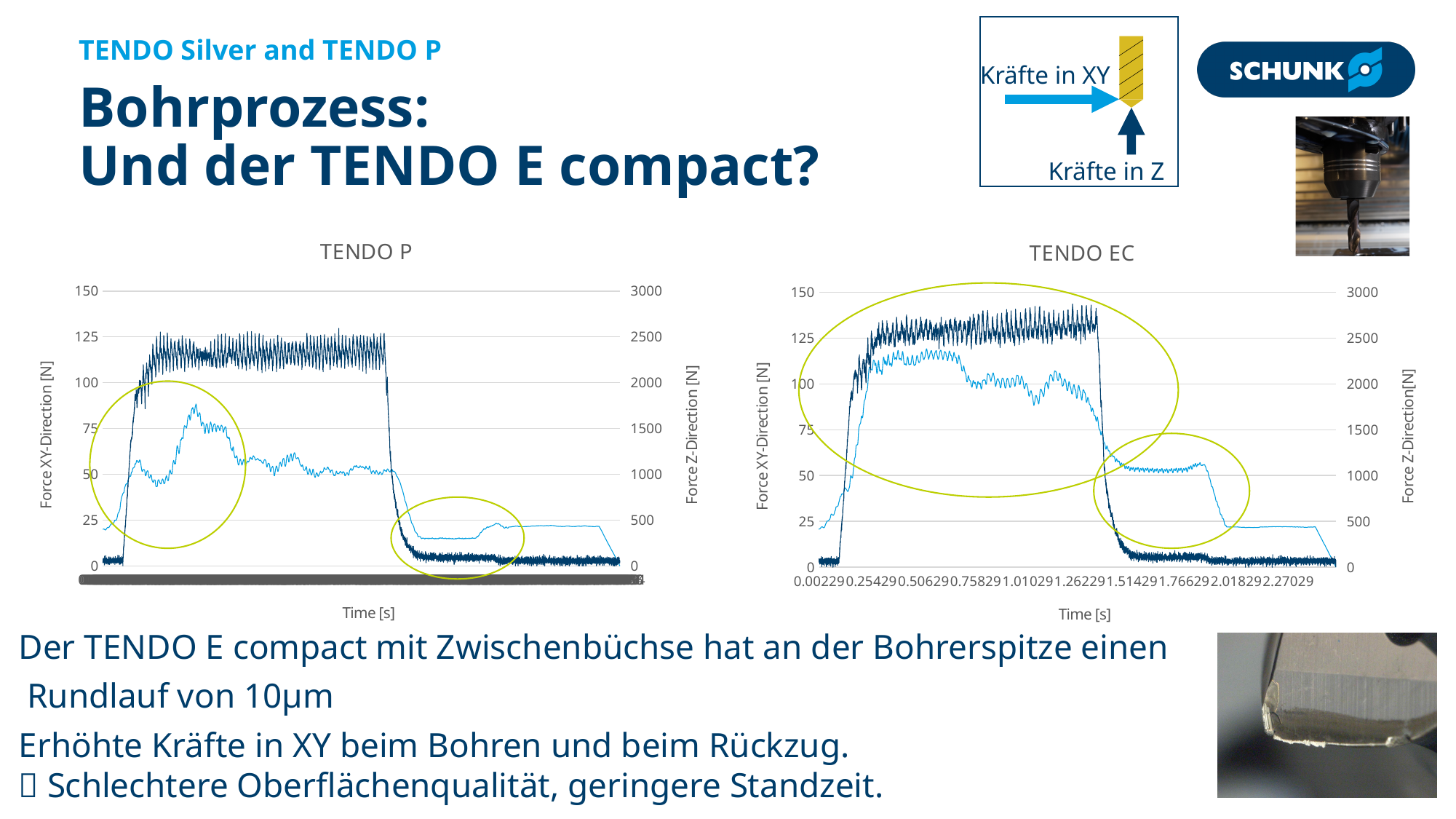
How many lines are plotted on the TENDO EC chart? 2 On the TENDO EC chart, is the plateau of the light blue line during drilling greater or less than 75 on the left axis? greater How many tick labels are printed on the x axis of the TENDO EC chart? 10 What is the label of the left vertical axis on the TENDO P chart? Force XY-Direction [N] On the TENDO EC chart, is the plateau of the dark blue line greater or less than 100 on the left axis? greater On the TENDO P chart, is the peak of the light blue line greater or less than 100 on the left axis? less On the TENDO EC chart, during the drilling plateau, which line is higher on the left axis, the dark blue line or the light blue line? dark blue line What is the title of the chart on the right side of the slide? TENDO EC What kind of chart is the TENDO P chart? line chart